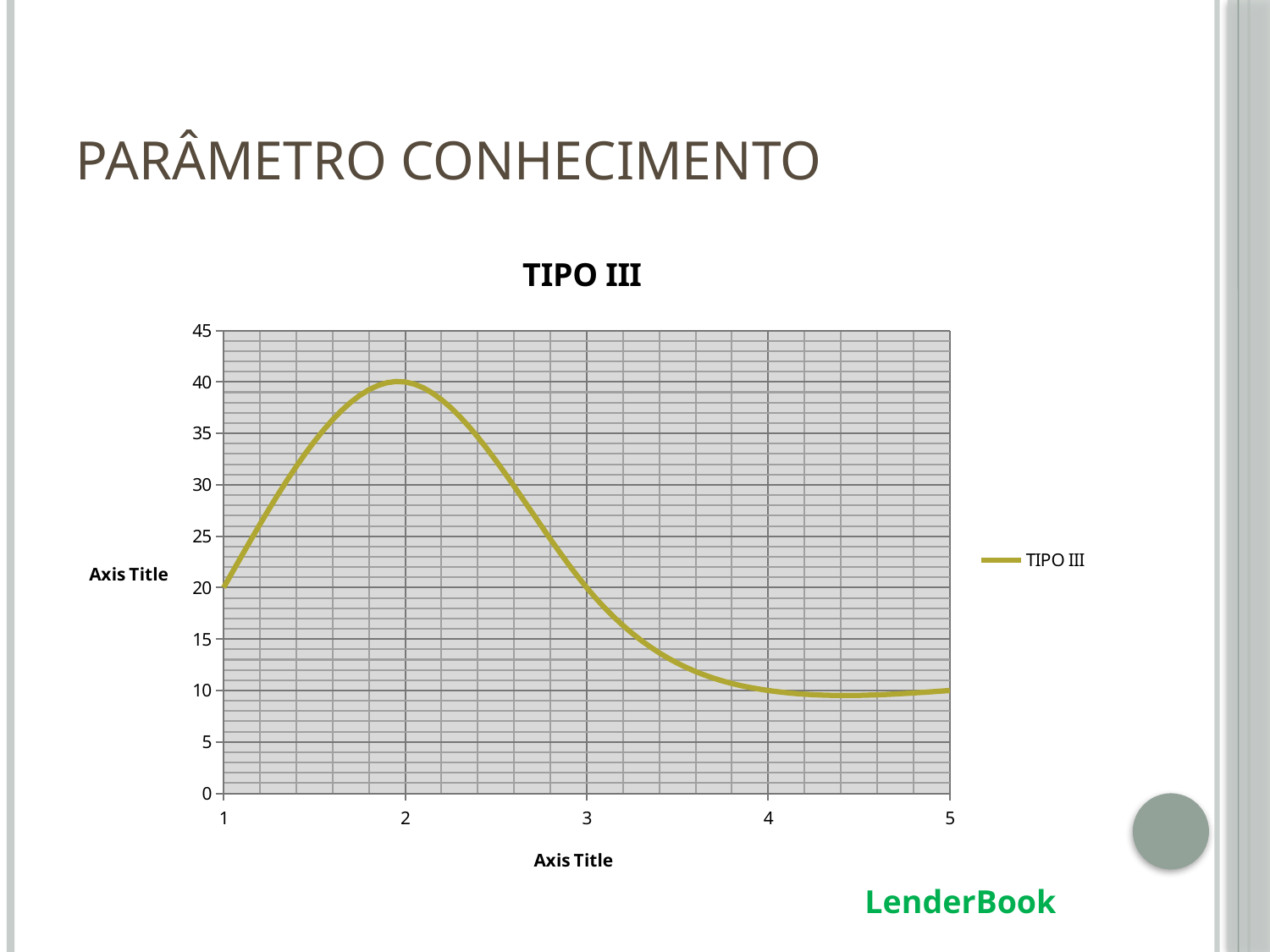
Does the TIPO III line rise or fall between x = 2 and x = 4? fall What is the title of the chart? TIPO III What is the value of TIPO III at x = 1? 20 Is the value of TIPO III at x = 3 greater or less than 30? less What is the value of TIPO III at x = 5? 10 Is the value of TIPO III at x = 4 greater or less than 15? less How many points are marked on the x axis of the chart? 5 Which is larger, the value of TIPO III at x = 2 or at x = 4? x = 2 At which x value does TIPO III reach its highest value? 2 How many series does the legend list? 1 What is the value of TIPO III at x = 2? 40 What kind of chart is shown on the slide? line chart